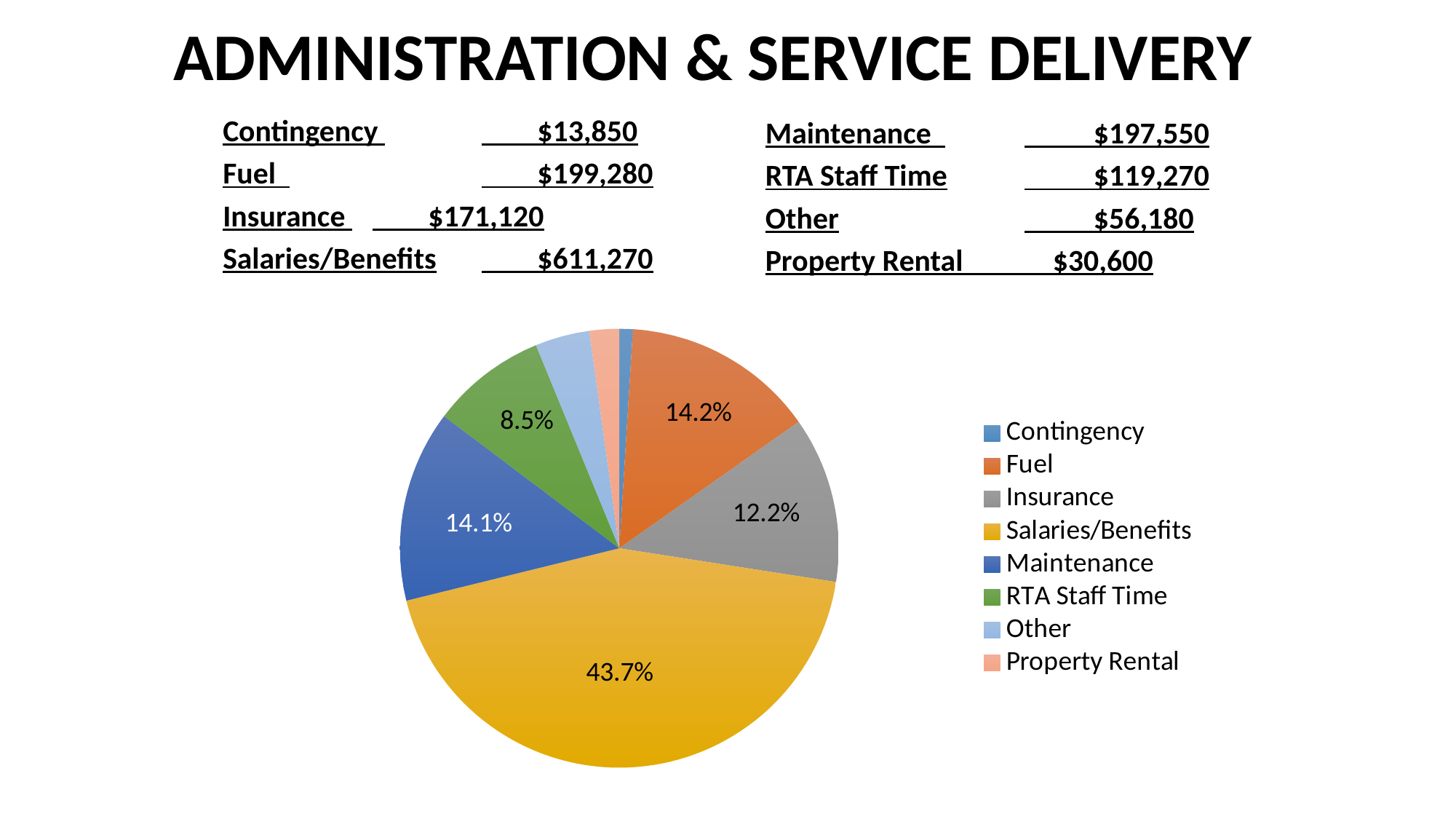
What share of the pie does Maintenance represent? 14.1% What share of the pie does RTA Staff Time represent? 8.5% What colour is the Salaries/Benefits slice in the pie chart? yellow What share of the pie does Fuel represent? 14.2% What is the difference in percentage points between the Salaries/Benefits slice and the Fuel slice? 29.5 Which category has the smallest slice of the pie? Contingency Which slice is larger, Fuel or Insurance? Fuel Which category has the largest slice of the pie? Salaries/Benefits What kind of chart is shown on the slide? pie chart How many categories does the pie chart show? 8